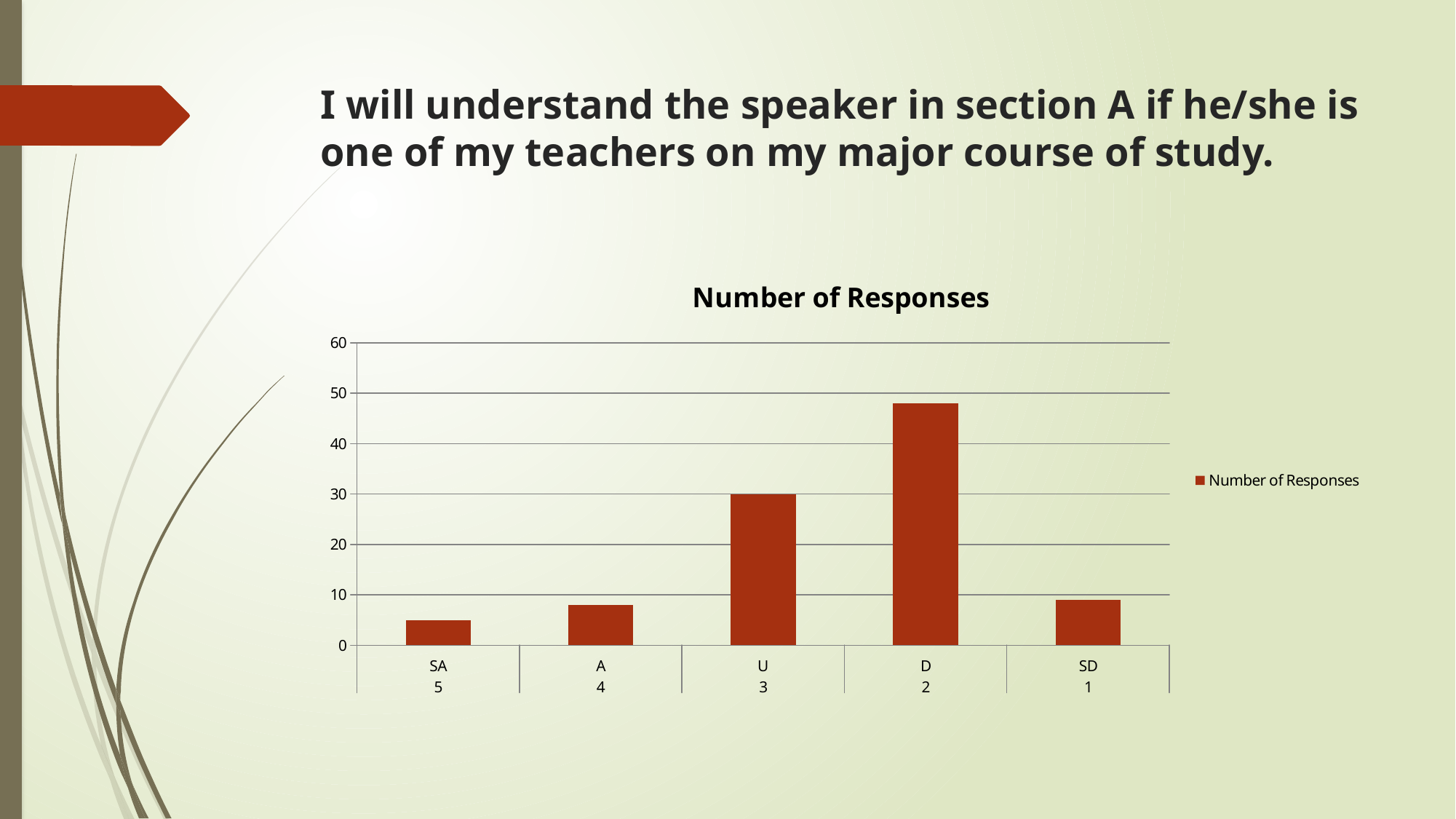
What kind of chart is shown on the slide? bar chart Which has more responses, U or D? D What is the title of the chart? Number of Responses Which category has the highest number of responses? D Is the number of responses for A greater or less than 10? less Which category has the lowest number of responses? SA Is the number of responses for D greater or less than 40? greater Is the number of responses for SD greater or less than 10? less How many series does the legend list? 1 What is the number of responses for U? 30 How many categories are shown on the x axis of the chart? 5 Which has more responses, SA or SD? SD